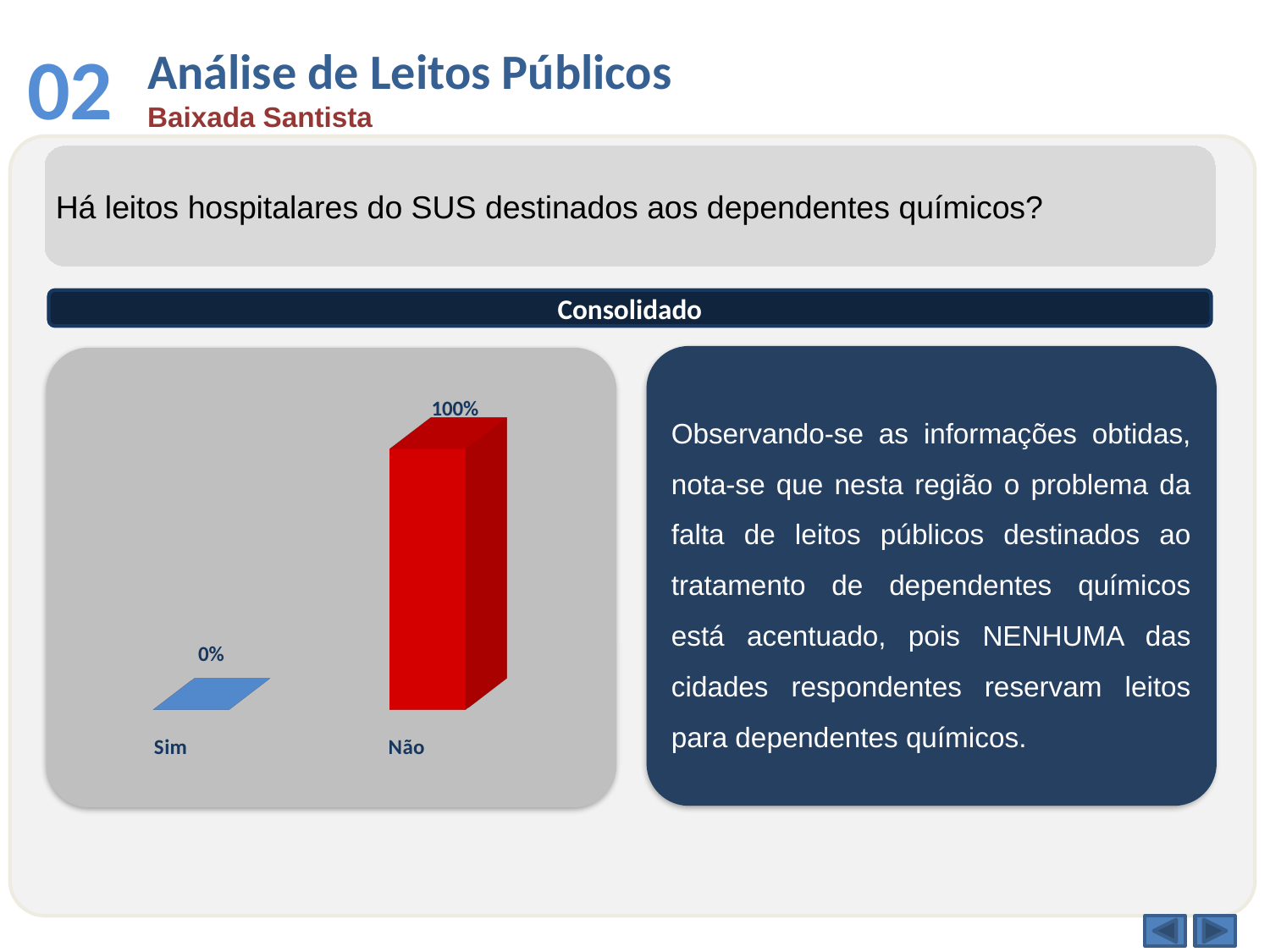
What is the difference between the values for "Não" and "Sim"? 100% What is the value for "Não"? 100% Which is larger, the value for "Sim" or the value for "Não"? Não How many categories are shown in the chart? 2 What is the label of the header bar above the chart? Consolidado What colour is the bar for "Não"? Red What is the value for "Sim"? 0% What is the total of the two values shown in the chart? 100% Which category has the lowest value? Sim Which category has the highest value? Não What kind of chart is shown on the slide? Bar chart